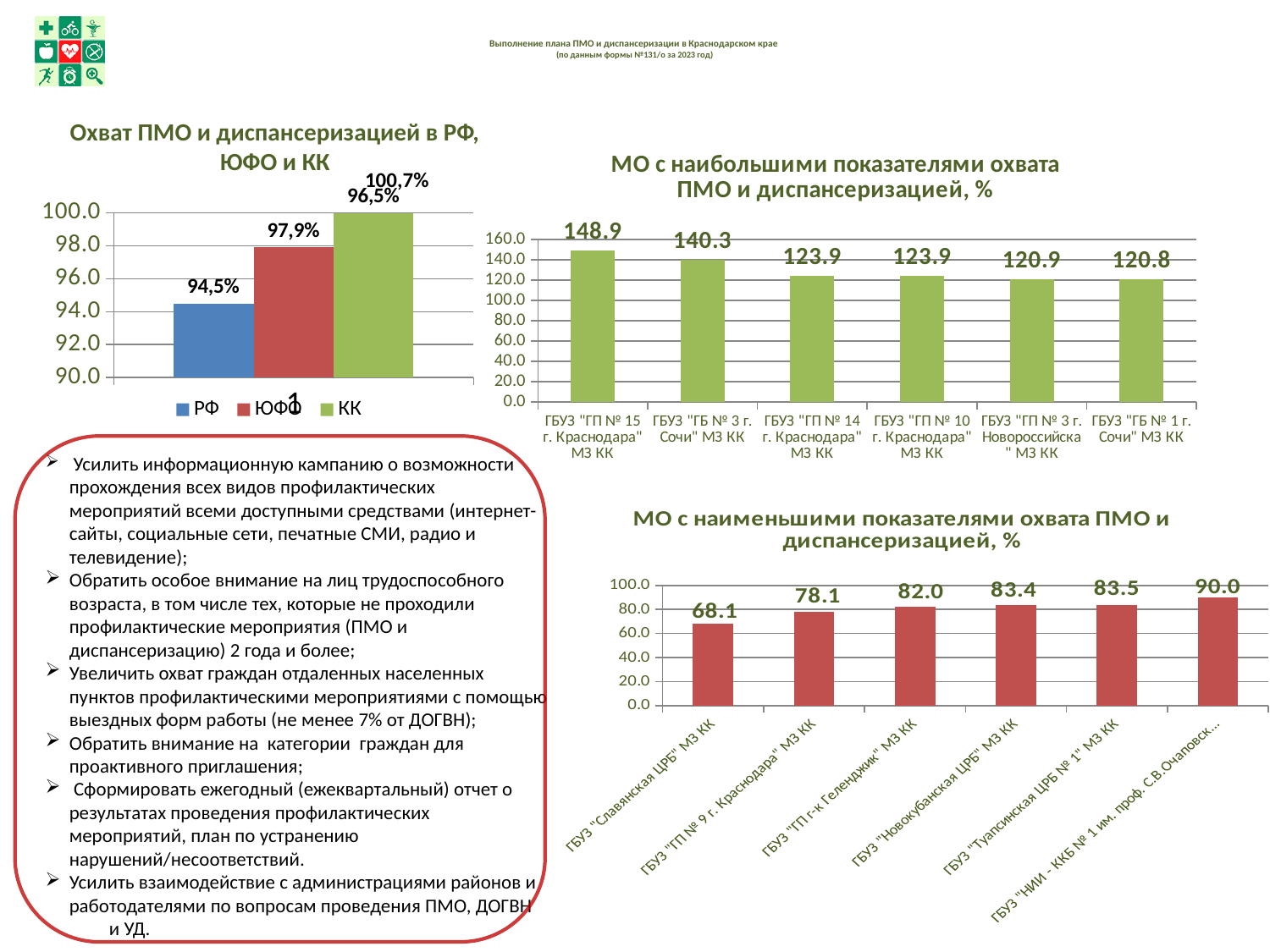
In the chart 'МО с наименьшими показателями охвата ПМО и диспансеризацией, %', what is the value for ГБУЗ "Славянская ЦРБ" МЗ КК? 68.1 In the chart 'МО с наибольшими показателями охвата ПМО и диспансеризацией, %', how many organisations are shown? 6 What kind of chart is 'МО с наименьшими показателями охвата ПМО и диспансеризацией, %'? bar chart In the chart 'МО с наименьшими показателями охвата ПМО и диспансеризацией, %', do the values rise or fall from left to right? rise In the chart 'МО с наибольшими показателями охвата ПМО и диспансеризацией, %', what is the difference between ГБУЗ "ГП № 15 г. Краснодара" МЗ КК and ГБУЗ "ГБ № 3 г. Сочи" МЗ КК? 8.6 In the chart 'МО с наибольшими показателями охвата ПМО и диспансеризацией, %', what is the value for ГБУЗ "ГП № 15 г. Краснодара" МЗ КК? 148.9 In the chart 'МО с наименьшими показателями охвата ПМО и диспансеризацией, %', which organisation has the highest value? ГБУЗ "НИИ - ККБ № 1 им. проф. С.В.Очаповск..." In the chart 'Охват ПМО и диспансеризацией в РФ, ЮФО и КК', how many series does the legend list? 3 In the chart 'МО с наибольшими показателями охвата ПМО и диспансеризацией, %', what is the value for ГБУЗ "ГБ № 1 г. Сочи" МЗ КК? 120.8 In the chart 'Охват ПМО и диспансеризацией в РФ, ЮФО и КК', what is the value for РФ? 94,5% In the chart 'Охват ПМО и диспансеризацией в РФ, ЮФО и КК', which series has the lowest value? РФ In the chart 'Охват ПМО и диспансеризацией в РФ, ЮФО и КК', what is the value for ЮФО? 97,9%